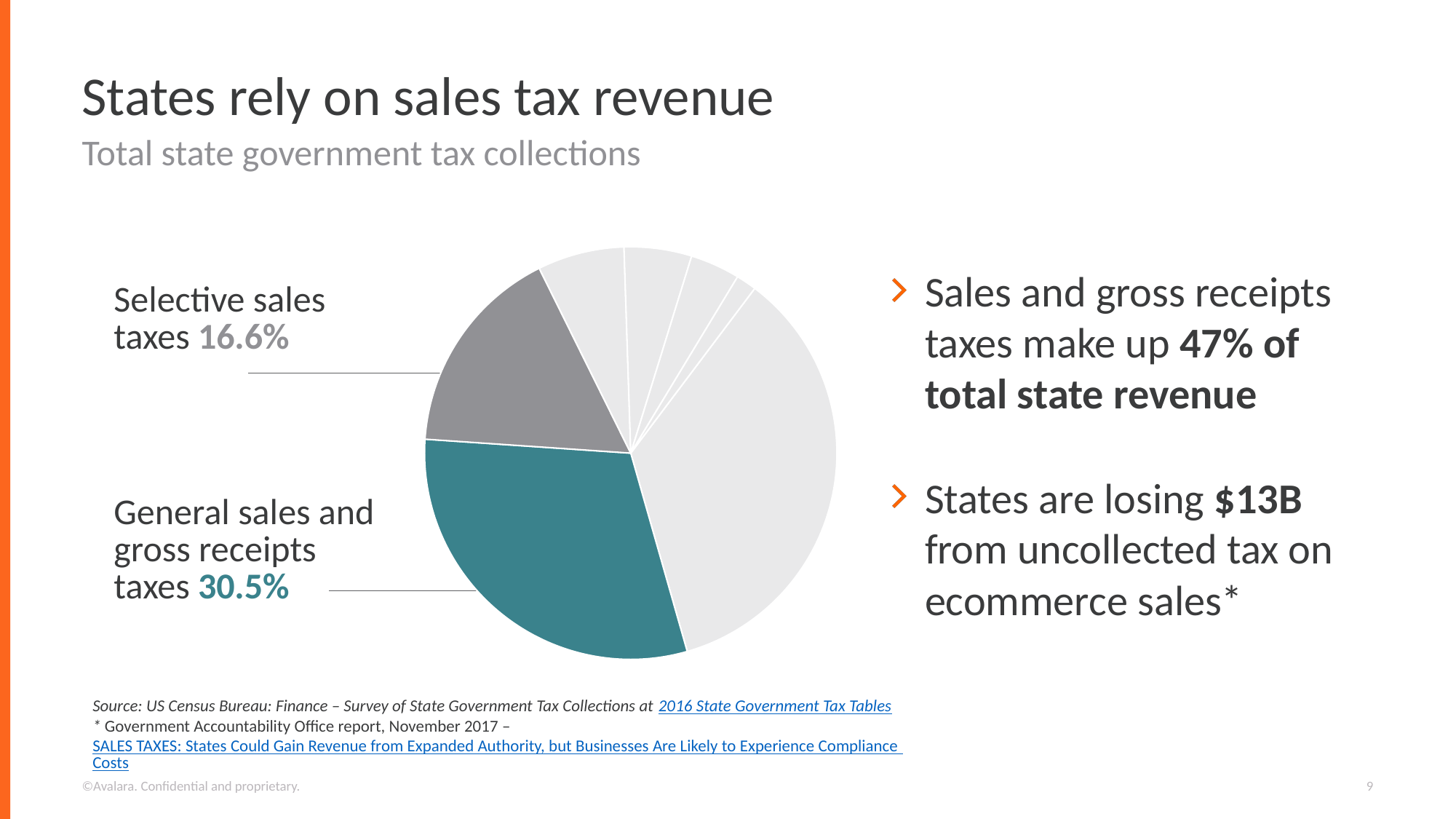
By how many percentage points does the general sales and gross receipts taxes share exceed the selective sales taxes share? 13.9 percentage points What share of the pie does the teal slice represent? 30.5% What kind of chart is shown on the slide? Pie chart Is the share for general sales and gross receipts taxes greater or less than 25%? greater What colour is the slice for general sales and gross receipts taxes? Teal Is the share for selective sales taxes greater or less than 20%? less What percentage of total state government tax collections comes from general sales and gross receipts taxes? 30.5% What percentage of total state government tax collections comes from selective sales taxes? 16.6% Of the two labeled slices, which represents the larger share of the pie? General sales and gross receipts taxes Of the two labeled slices, which represents the smaller share of the pie? Selective sales taxes Which is larger: the share for general sales and gross receipts taxes or the share for selective sales taxes? General sales and gross receipts taxes What is the subtitle describing what the pie chart shows? Total state government tax collections